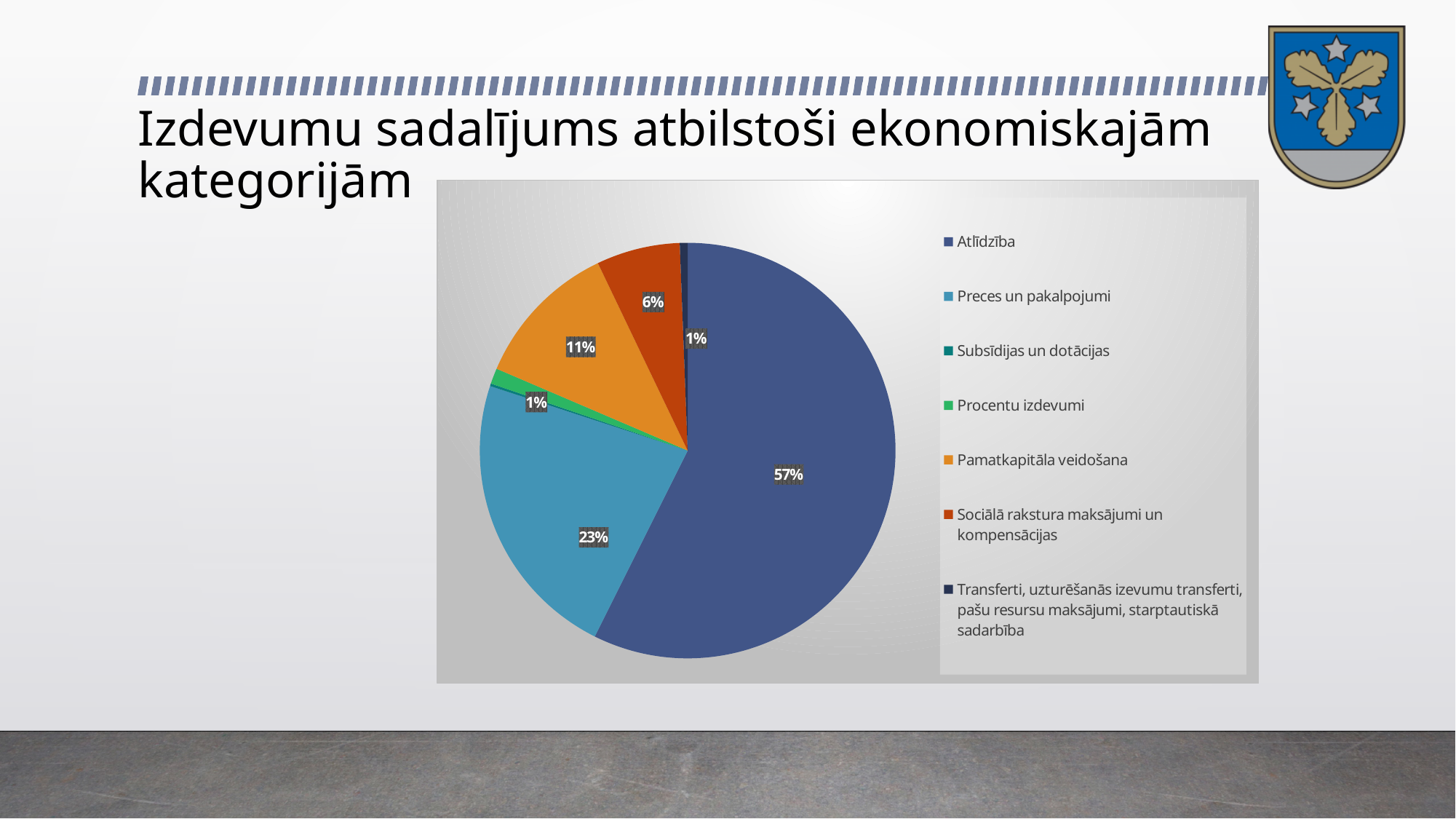
What share of the pie does Sociālā rakstura maksājumi un kompensācijas represent? 6% Which category has the largest slice of the pie? Atlīdzība What share of the pie does Atlīdzība represent? 57% What share of the pie does Preces un pakalpojumi represent? 23% Which is larger, the slice for Preces un pakalpojumi or the slice for Pamatkapitāla veidošana? Preces un pakalpojumi What kind of chart is shown on the slide? pie chart What is the difference in percentage points between the Atlīdzība slice and the Preces un pakalpojumi slice? 34 What is the difference in percentage points between the Pamatkapitāla veidošana slice and the Sociālā rakstura maksājumi un kompensācijas slice? 5 How many categories does the legend list? 7 What is the title of the slide containing the chart? Izdevumu sadalījums atbilstoši ekonomiskajām kategorijām